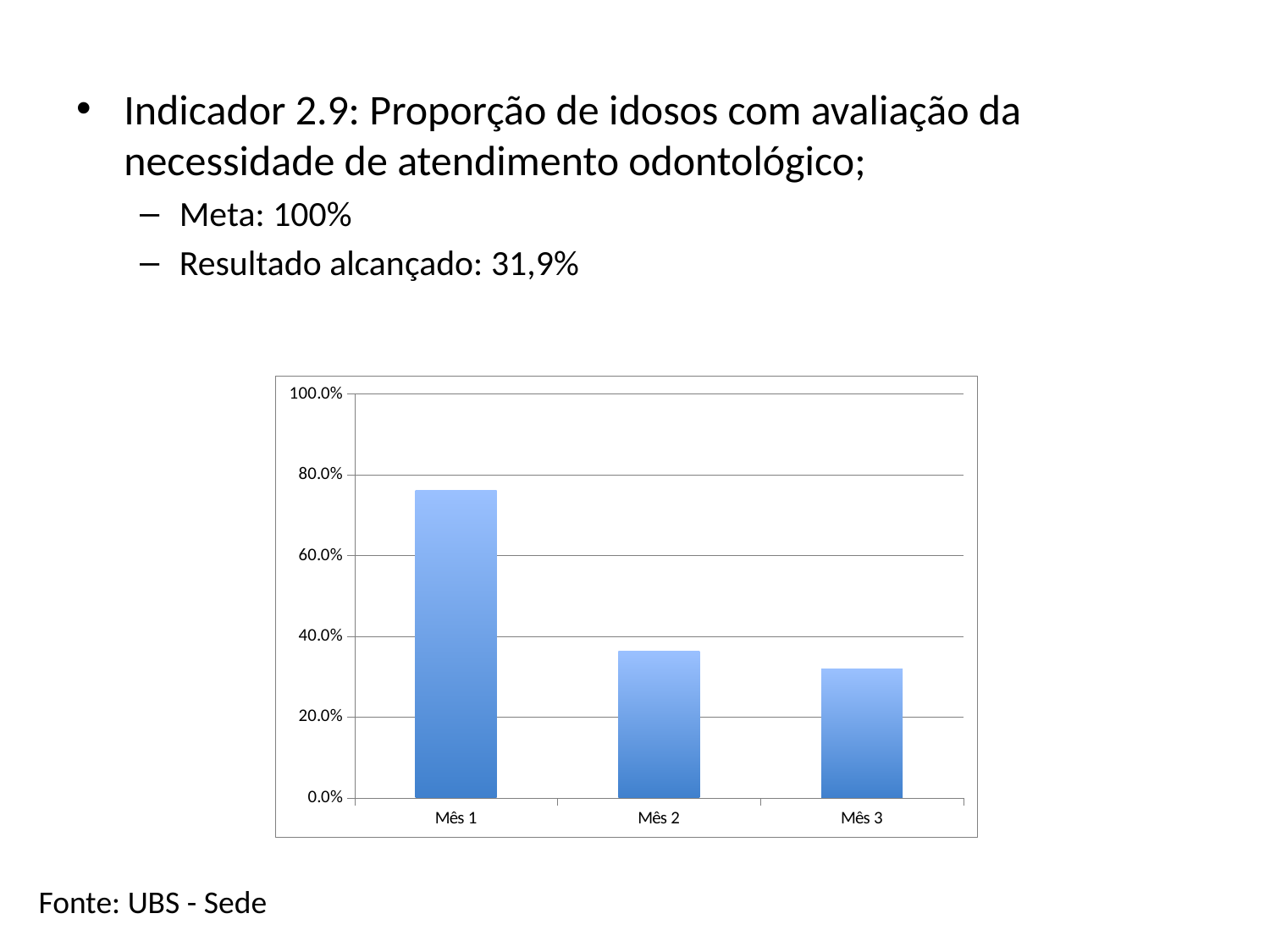
Is the value for Mês 1 greater or less than 60.0%? greater What kind of chart is shown on the slide? bar chart Is the value for Mês 2 greater or less than 40.0%? less Is the value for Mês 2 greater or less than 20.0%? greater Which is larger, the value for Mês 1 or the value for Mês 3? Mês 1 Which month has the highest bar in the chart? Mês 1 Which month has the lowest bar in the chart? Mês 3 Do the values rise or fall from Mês 1 to Mês 3? fall What is the highest value shown on the y axis of the chart? 100.0% How many categories are plotted on the x axis of the chart? 3